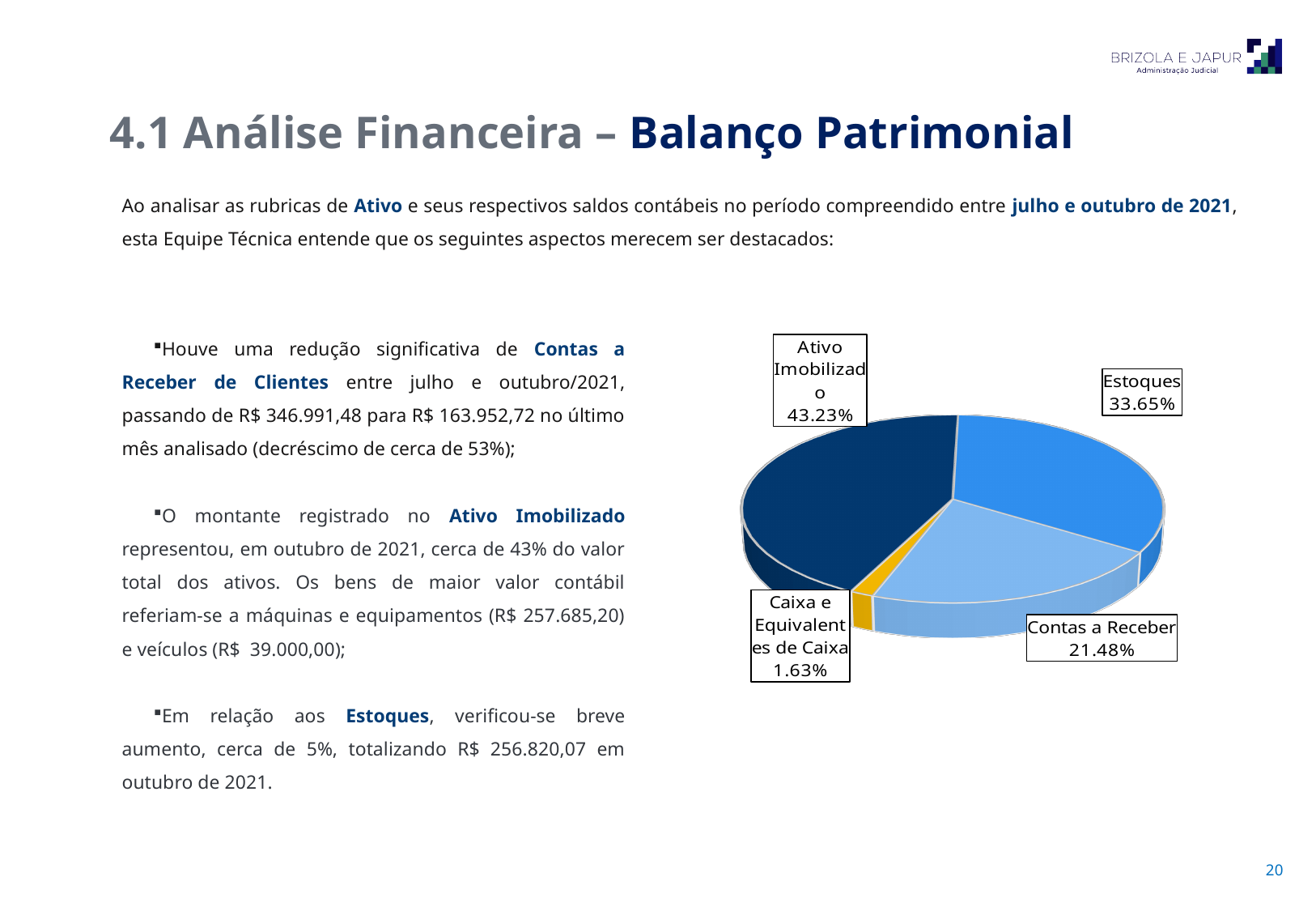
Which category has the largest slice of the pie? Ativo Imobilizado What kind of chart is shown on the slide? Pie chart What is the difference in percentage points between Ativo Imobilizado and Estoques? 9.58 What colour is the slice for Caixa e Equivalentes de Caixa? Yellow What is the difference in percentage points between Estoques and Contas a Receber? 12.17 What percentage is shown for Caixa e Equivalentes de Caixa? 1.63% How many slices does the pie chart have? 4 What percentage is shown for Contas a Receber? 21.48% Which category has the smallest slice of the pie? Caixa e Equivalentes de Caixa Which is larger, the share for Estoques or the share for Contas a Receber? Estoques What share of the pie does Ativo Imobilizado represent? 43.23% What percentage is shown for Estoques? 33.65%